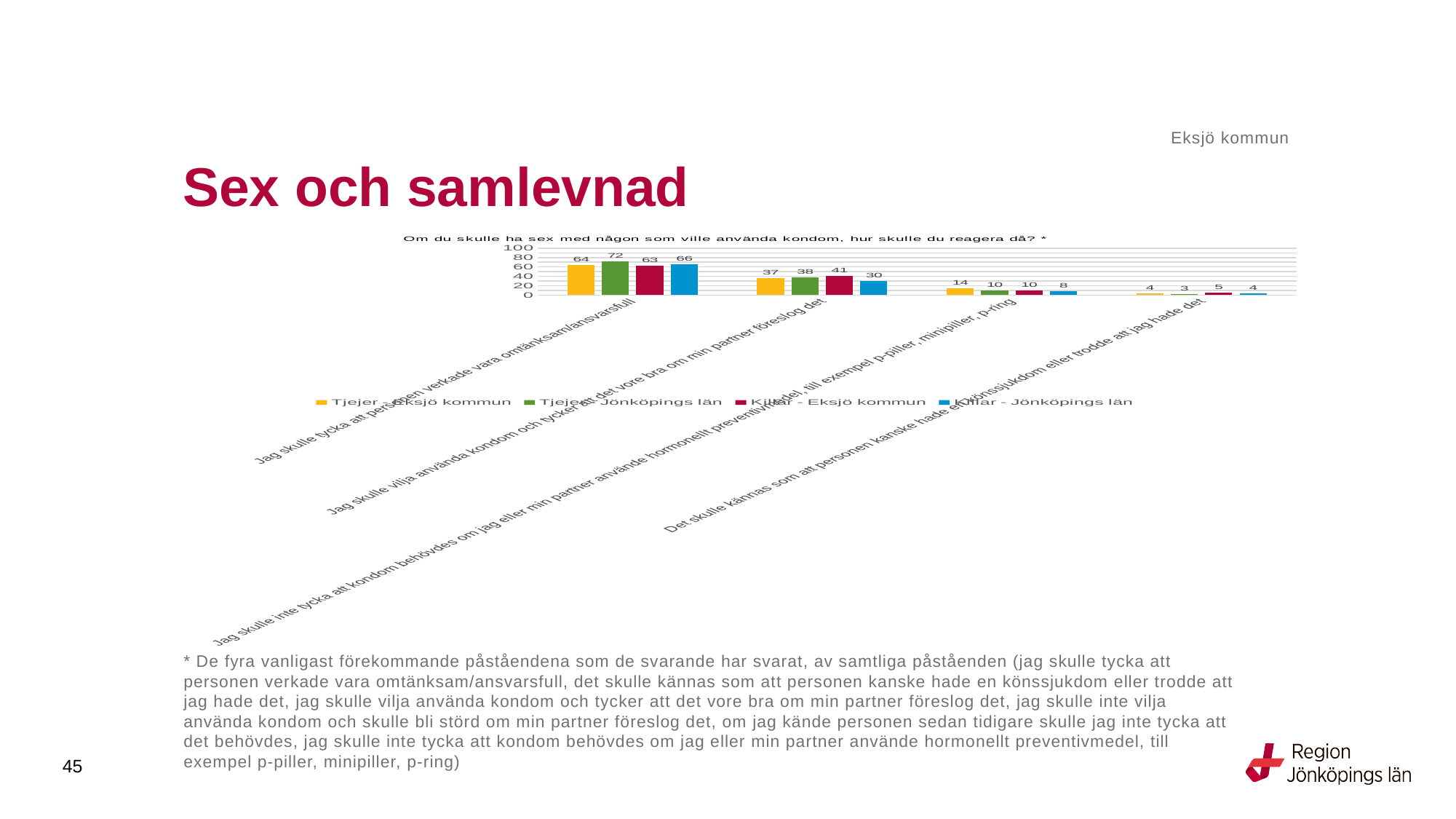
For the statement 'Jag skulle vilja använda kondom och tycker att det vore bra om min partner föreslog det', which is larger: Killar - Eksjö kommun or Killar - Jönköpings län? Killar - Eksjö kommun What is the value for Tjejer - Jönköpings län for the statement 'Jag skulle tycka att personen verkade vara omtänksam/ansvarsfull'? 72 Which series has the highest value for the statement 'Jag skulle tycka att personen verkade vara omtänksam/ansvarsfull'? Tjejer - Jönköpings län How many series does the legend list? 4 What is the value for Tjejer - Eksjö kommun for the statement about not thinking a condom is needed if hormonal contraception is used? 14 Which series has the lowest value for the statement about not thinking a condom is needed if hormonal contraception is used? Killar - Jönköpings län How many categories (statements) are plotted on the x axis? 4 What is the value for Killar - Jönköpings län for the statement 'Det skulle kännas som att personen kanske hade en könssjukdom eller trodde att jag hade det'? 4 Which colour represents Killar - Eksjö kommun in the chart? red What kind of chart is shown on the slide? bar chart What is the difference between Tjejer - Jönköpings län and Killar - Eksjö kommun for the statement 'Jag skulle tycka att personen verkade vara omtänksam/ansvarsfull'? 9 What is the value for Killar - Eksjö kommun for the statement 'Jag skulle vilja använda kondom och tycker att det vore bra om min partner föreslog det'? 41